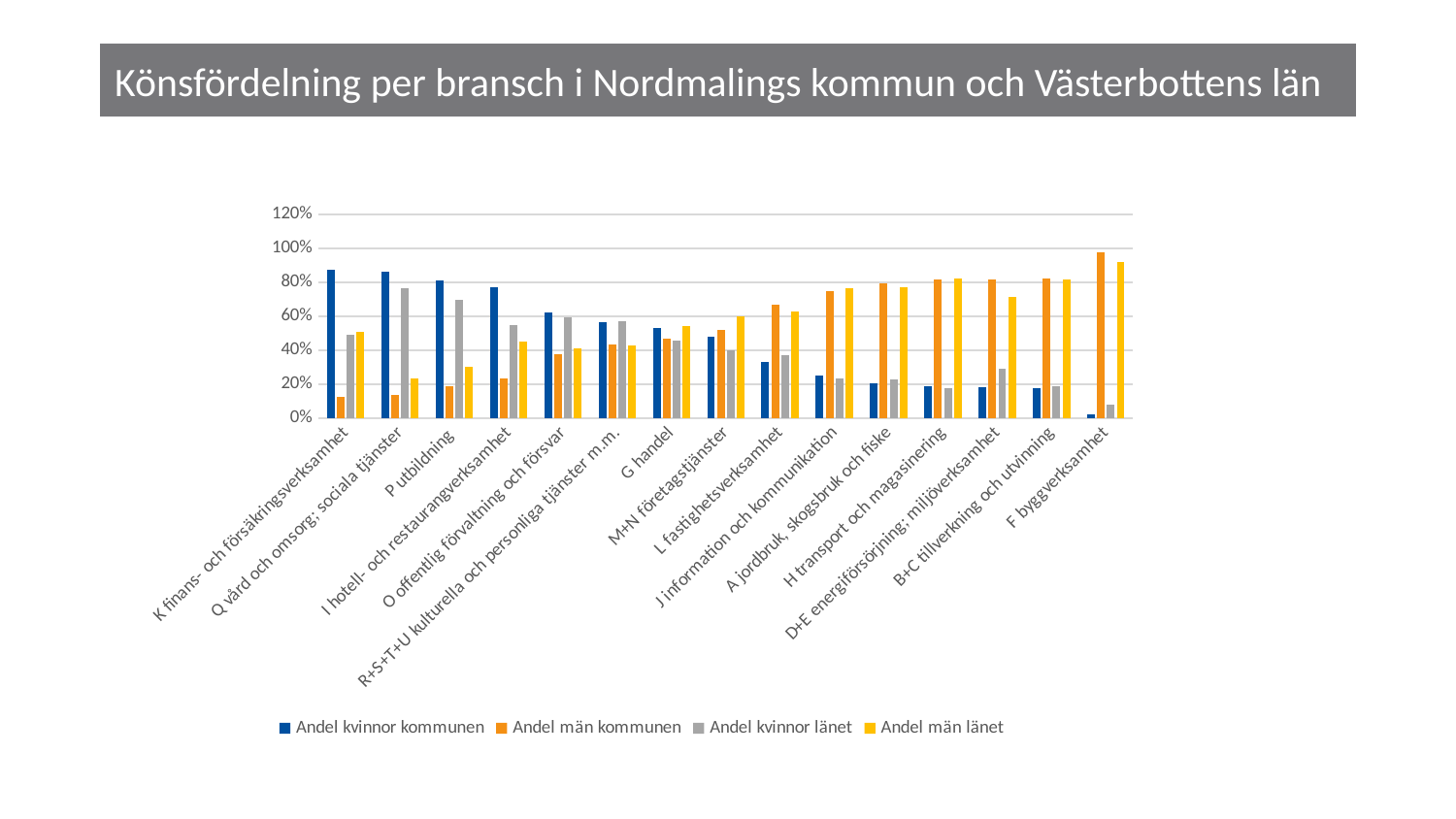
Which category has the highest value for Andel män länet? F byggverksamhet How many industry categories are shown on the x axis? 15 Is the value for Andel män kommunen in K finans- och försäkringsverksamhet greater or less than 20%? less Do the values for Andel kvinnor kommunen generally rise or fall from left to right along the x axis? fall Which category has the highest value for Andel män kommunen? F byggverksamhet Which category has the lowest value for Andel kvinnor kommunen? F byggverksamhet For K finans- och försäkringsverksamhet, which is larger: Andel kvinnor kommunen or Andel kvinnor länet? Andel kvinnor kommunen Is the value for Andel kvinnor länet in Q vård och omsorg; sociala tjänster greater or less than 60%? greater Is the value for Andel män länet in A jordbruk, skogsbruk och fiske greater or less than 60%? greater How many series does the legend list? 4 What kind of chart is shown on the slide? Bar chart